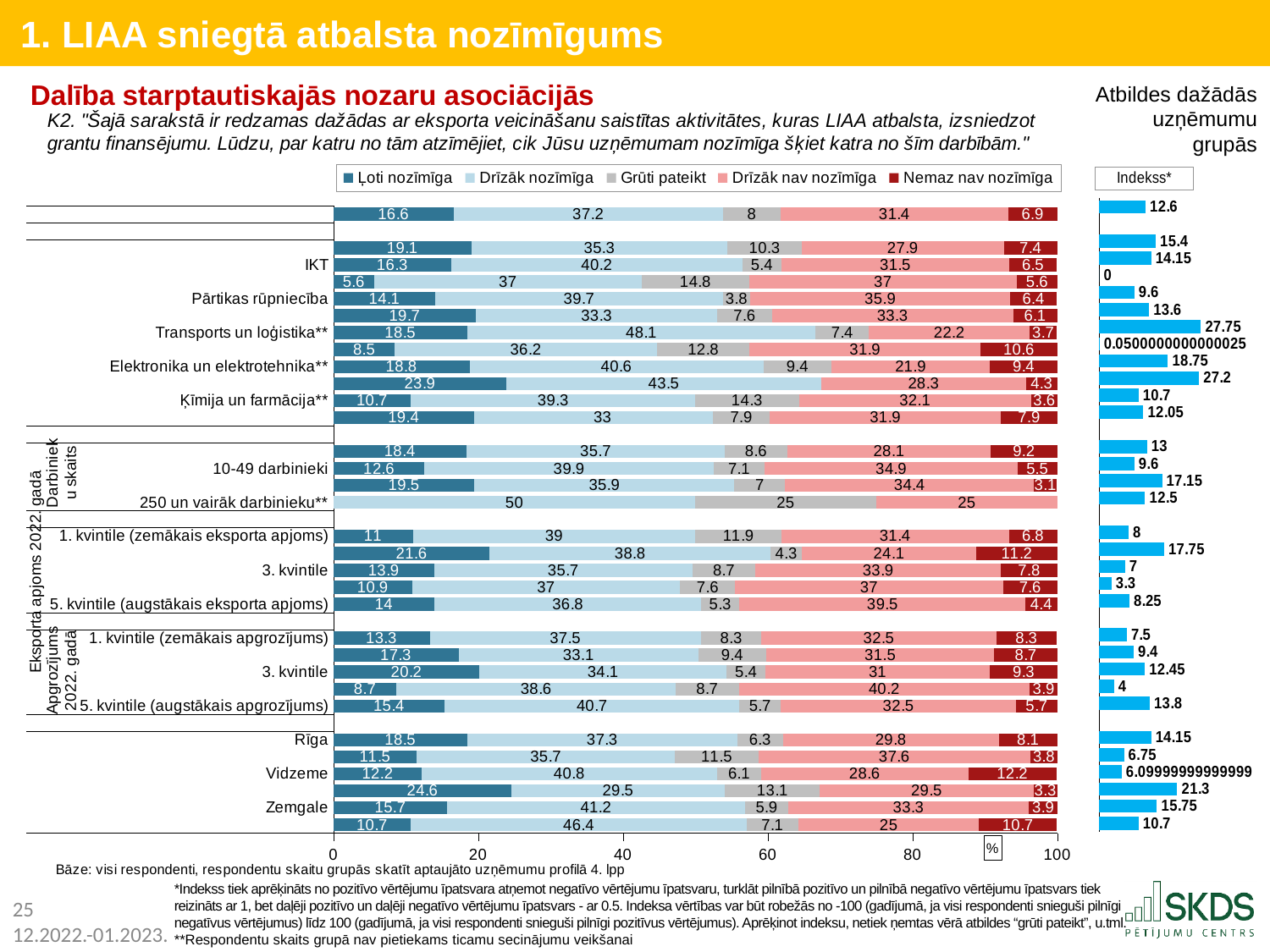
What kind of chart is the main chart on the slide? Stacked bar chart In the Indekss* chart, what is the index value for Zemgale? 15.75 In the stacked bar chart, what is the value of 'Nemaz nav nozīmīga' for Vidzeme? 12.2 In the stacked bar chart, what is the value of 'Drīzāk nav nozīmīga' for Pārtikas rūpniecība? 35.9 How many series does the legend of the stacked bar chart list? 5 In the Indekss* chart, what is the index value for Transports un loģistika**? 27.75 In the stacked bar chart, what is the value of 'Ļoti nozīmīga' for Zemgale? 15.7 In the stacked bar chart, what is the value of 'Drīzāk nozīmīga' for Transports un loģistika**? 48.1 In the stacked bar chart, what is the value of 'Grūti pateikt' for Ķīmija un farmācija**? 14.3 In the stacked bar chart, which is larger: the 'Ļoti nozīmīga' value for Rīga or for Vidzeme? Rīga In the stacked bar chart, what is the value of 'Ļoti nozīmīga' for IKT? 16.3 In the stacked bar chart, what is the difference between the 'Drīzāk nav nozīmīga' values for 5. kvintile (augstākais eksporta apjoms) and 1. kvintile (zemākais eksporta apjoms)? 8.1